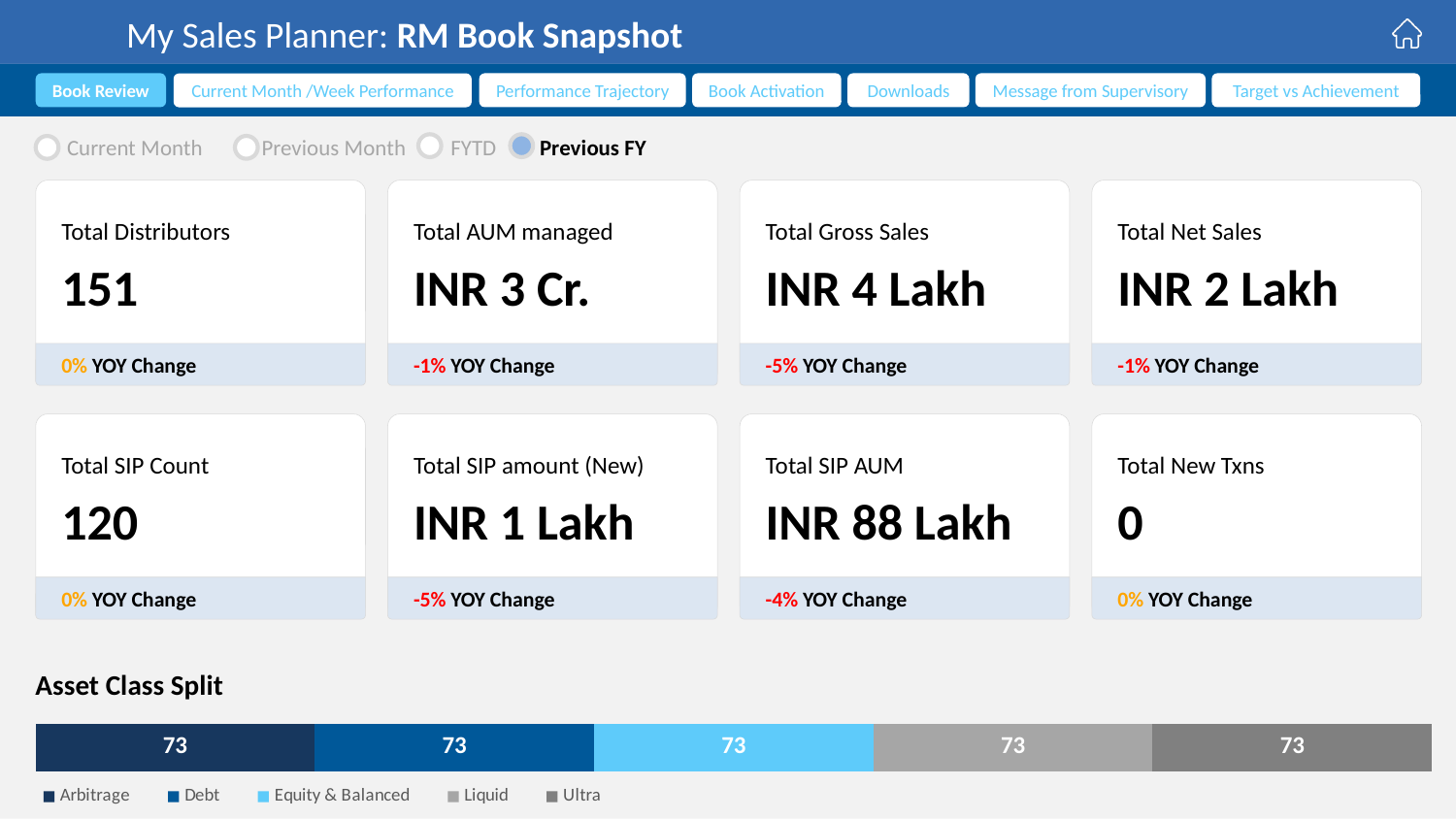
In the Asset Class Split chart, what is the value for Debt? 73 What is the total of the stacked bar in the Asset Class Split chart? 365 In the Asset Class Split chart, what is the difference between the values for Debt and Liquid? 0 What kind of chart is the Asset Class Split chart? Stacked bar chart How many series does the legend of the Asset Class Split chart list? 5 In the Asset Class Split chart, what is the value for Ultra? 73 What is the title of the stacked bar chart at the bottom of the slide? Asset Class Split In the Asset Class Split chart, what is the value for Arbitrage? 73 In the Asset Class Split chart, what is the value for Liquid? 73 In the Asset Class Split chart, which legend entry is shown in light blue? Equity & Balanced In the Asset Class Split chart, what is the value for Equity & Balanced? 73